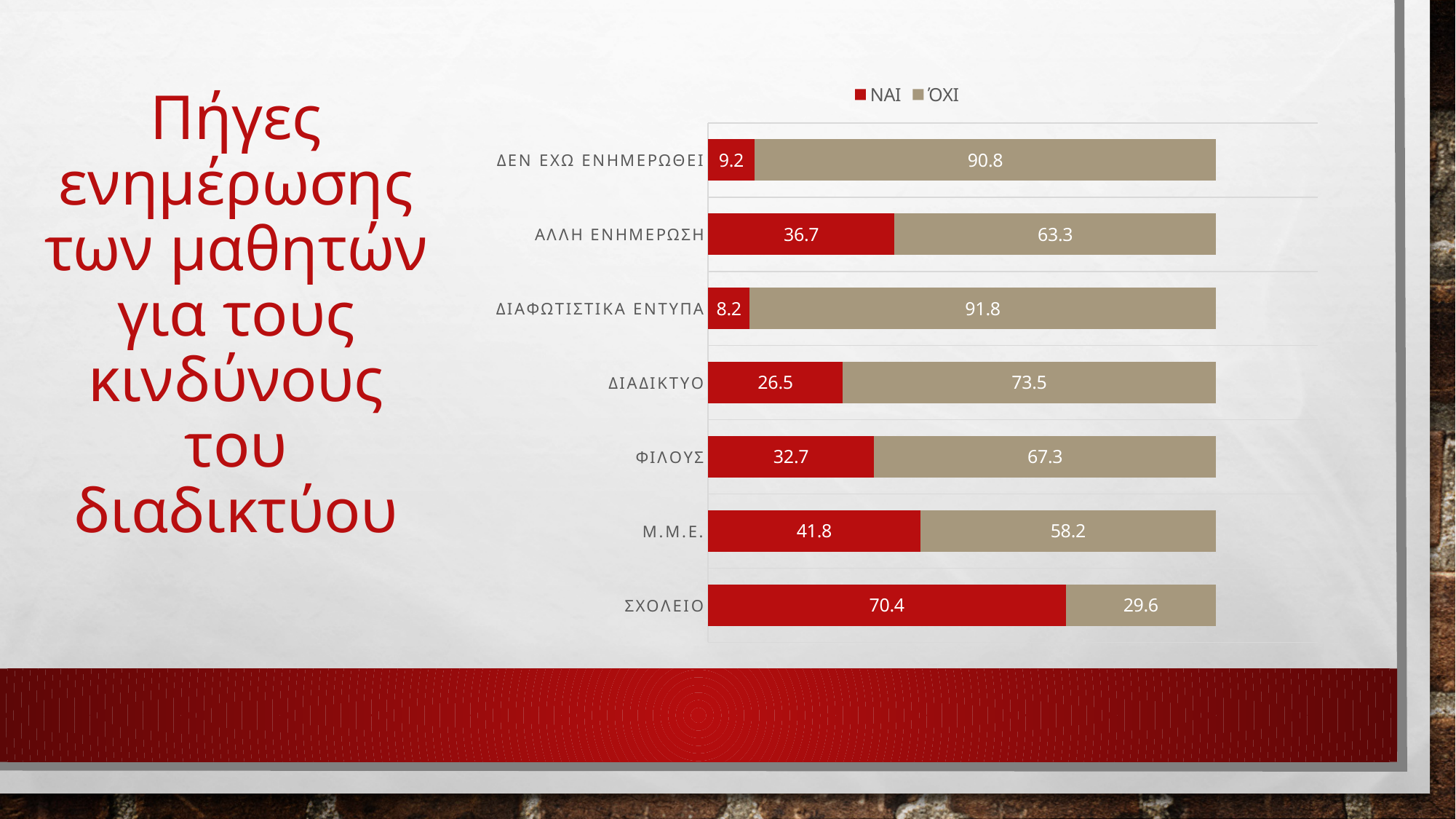
Which category has the highest ΝΑΙ value? ΣΧΟΛΕΙΟ Which category has the lowest ΝΑΙ value? ΔΙΑΦΩΤΙΣΤΙΚΑ ΕΝΤΥΠΑ What is the difference between the ΝΑΙ values for ΣΧΟΛΕΙΟ and Μ.Μ.Ε.? 28.6 What is the total of the stacked bar for ΑΛΛΗ ΕΝΗΜΕΡΩΣΗ? 100 What kind of chart is shown on the slide? Stacked bar chart How many series does the legend list? 2 How many categories are shown in the chart? 7 What is the ΝΑΙ value for ΣΧΟΛΕΙΟ? 70.4 What is the ΝΑΙ value for Μ.Μ.Ε.? 41.8 Which colour represents the ΝΑΙ series in the chart? Red Which has a larger ΝΑΙ value, ΦΙΛΟΥΣ or ΔΙΑΔΙΚΤΥΟ? ΦΙΛΟΥΣ What is the ΌΧΙ value for ΔΙΑΔΙΚΤΥΟ? 73.5